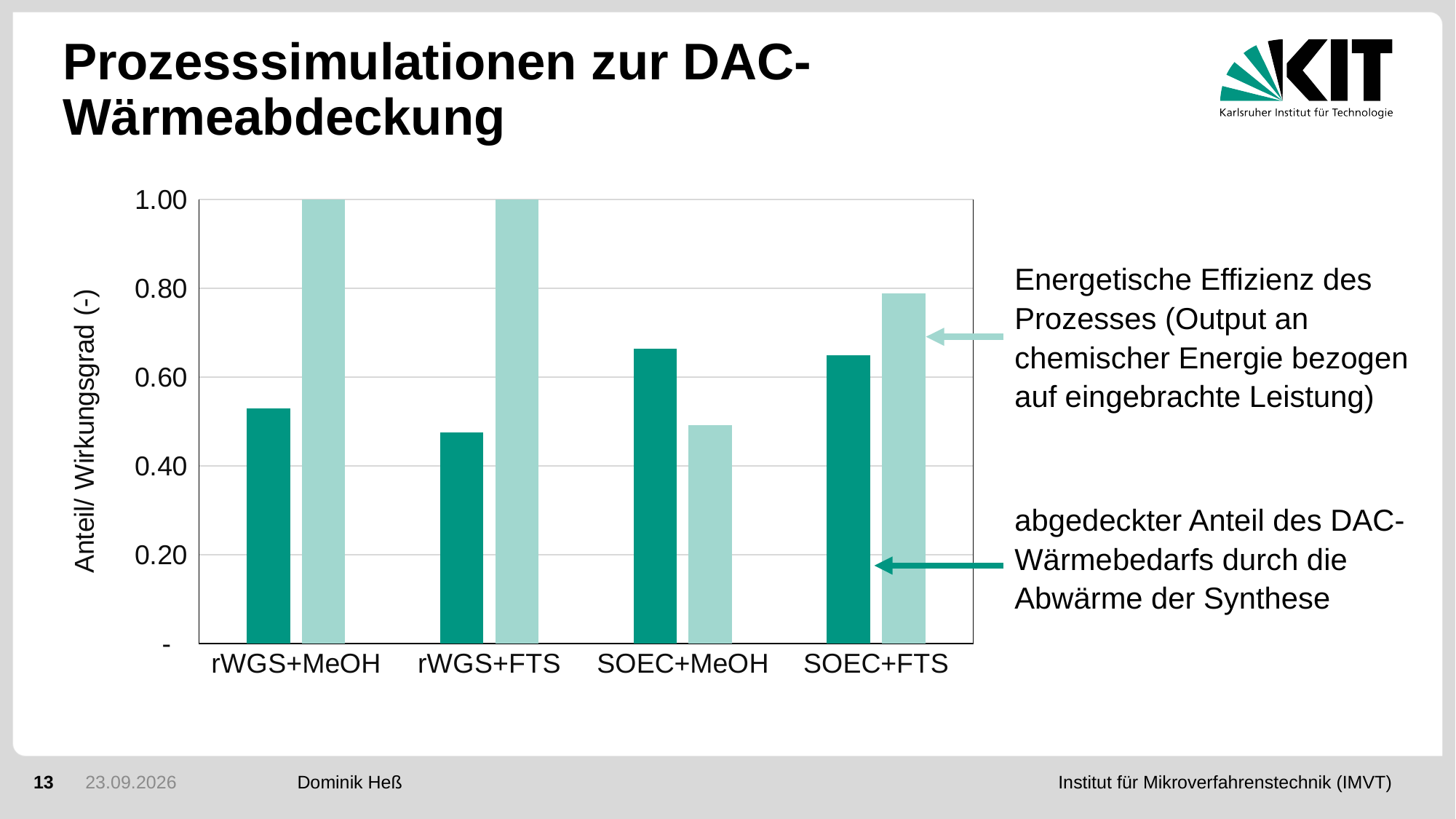
How many data series are plotted for each category in the chart? 2 What is the energetic efficiency (light green bar) for rWGS+FTS? 1.00 Is the covered share of DAC heat demand (dark green bar) for rWGS+MeOH greater or less than 0.60? less What is the label of the y axis of the chart? Anteil/ Wirkungsgrad (-) How many categories are shown on the x axis of the chart? 4 What is the energetic efficiency (light green bar) for rWGS+MeOH? 1.00 Is the energetic efficiency (light green bar) for SOEC+MeOH greater or less than 0.60? less For SOEC+MeOH, which is larger: the covered share of DAC heat demand (dark green) or the energetic efficiency (light green)? covered share of DAC heat demand (dark green) Is the covered share of DAC heat demand (dark green bar) for SOEC+MeOH greater or less than 0.60? greater What kind of chart is shown on the slide? bar chart Which category has the lowest energetic efficiency (light green bar)? SOEC+MeOH